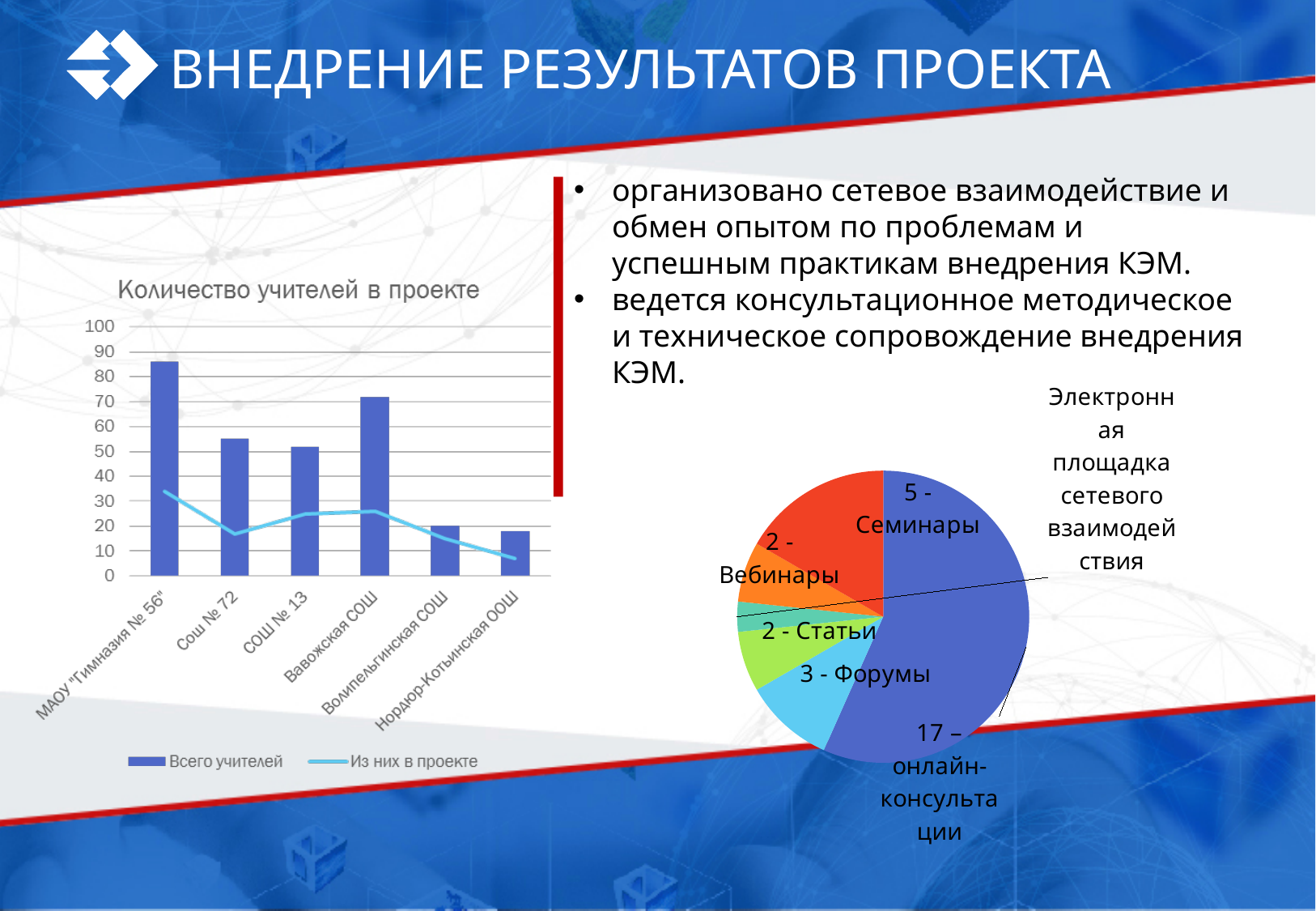
In the chart titled "Количество учителей в проекте", what are the two legend entries? Всего учителей; Из них в проекте In the chart titled "Количество учителей в проекте", is the "Всего учителей" value for Волипельгинская СОШ greater or less than 30? less In the pie chart on the right, which category has the largest slice? онлайн-консультации In the chart titled "Количество учителей в проекте", which has the larger "Всего учителей" bar: Вавожская СОШ or Сош № 72? Вавожская СОШ In the chart titled "Количество учителей в проекте", is the "Всего учителей" value for МАОУ "Гимназия № 56" greater or less than 80? greater In the chart titled "Количество учителей в проекте", how many schools are shown on the x axis? 6 In the chart titled "Количество учителей в проекте", how many series does the legend list? 2 In the pie chart on the right, what is the value for Форумы? 3 In the pie chart on the right, what is the difference between the value for онлайн-консультации and the value for Семинары? 12 In the chart titled "Количество учителей в проекте", is the "Из них в проекте" value for Нордюр-Котьинская ООШ greater or less than 10? less In the chart titled "Количество учителей в проекте", which school has the highest bar for "Всего учителей"? МАОУ "Гимназия № 56" What kind of chart is the one on the right side of the slide? pie chart